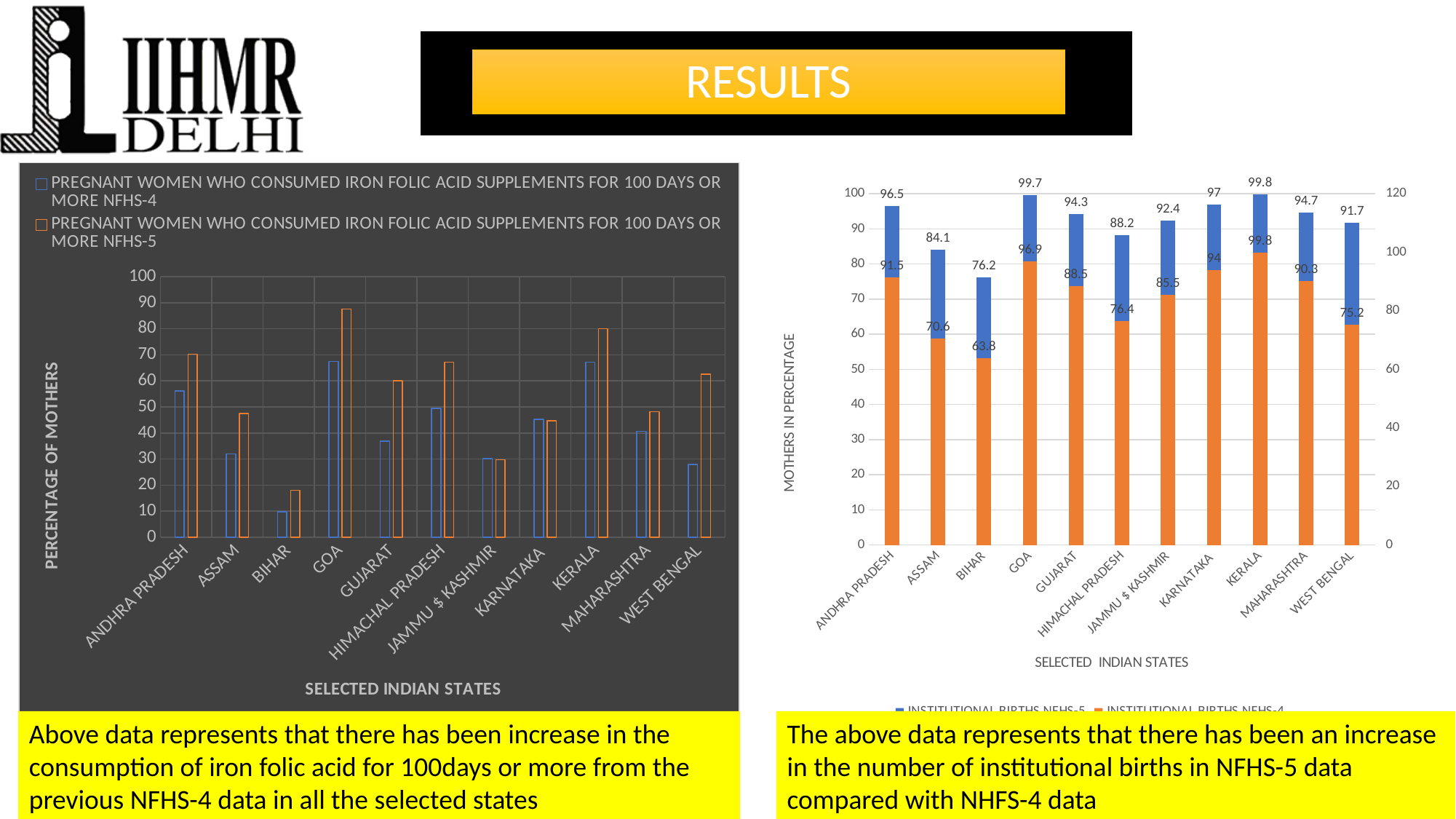
In the right chart (institutional births), what is the difference between the NFHS-5 and NFHS-4 values for Assam? 13.5 In the right chart (institutional births), which state has the lowest NFHS-4 value? Bihar In the right chart (institutional births), what is the NFHS-4 value for Bihar? 63.8 In the right chart (institutional births), which is larger for Himachal Pradesh: the NFHS-5 value or the NFHS-4 value? NFHS-5 In the left chart (iron folic acid supplements), is the NFHS-4 value for Bihar greater or less than 20? less In the left chart (iron folic acid supplements), is the NFHS-5 value for Goa greater or less than 80? greater In the right chart (institutional births), which state has the highest NFHS-5 value? Kerala How many states are shown on the x axis of the right chart (institutional births)? 11 In the right chart (institutional births), what is the NFHS-4 value for West Bengal? 75.2 How many series does the legend of the left chart (iron folic acid supplements) list? 2 In the right chart (institutional births), what is the NFHS-5 value for Goa? 99.7 In the left chart (iron folic acid supplements), which state has the highest NFHS-5 value? Goa